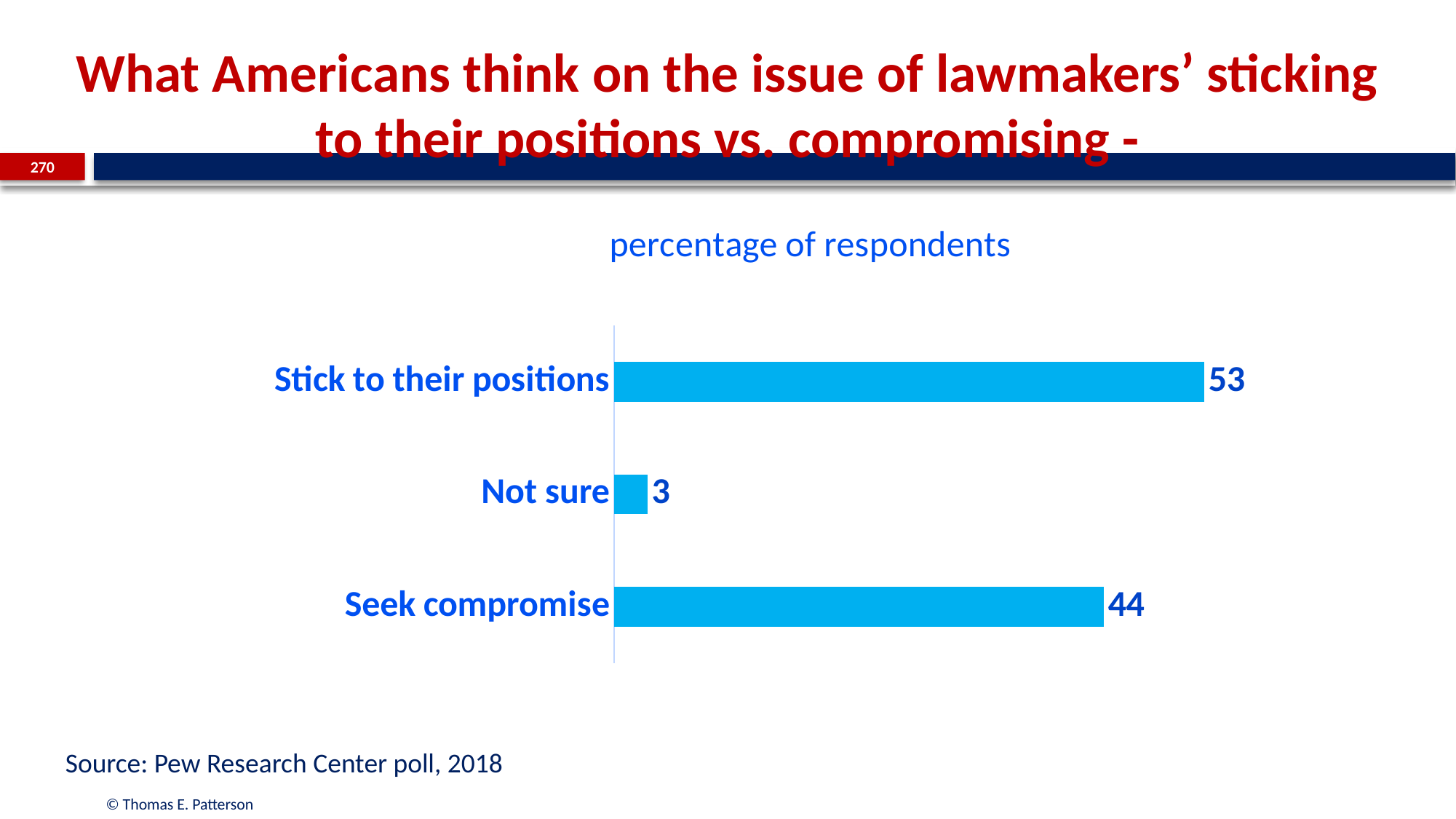
Which category has the highest value? Stick to their positions Which category has the lowest value? Not sure What kind of chart is shown on the slide? bar chart What is the source cited for the chart data? Pew Research Center poll, 2018 What is the value for Not sure? 3 What is the difference between the values for Stick to their positions and Seek compromise? 9 What is the title of the chart? percentage of respondents What is the difference between the values for Seek compromise and Not sure? 41 How many categories are shown in the chart? 3 What is the value for Seek compromise? 44 Which is larger, the value for Stick to their positions or the value for Seek compromise? Stick to their positions What is the value for Stick to their positions? 53